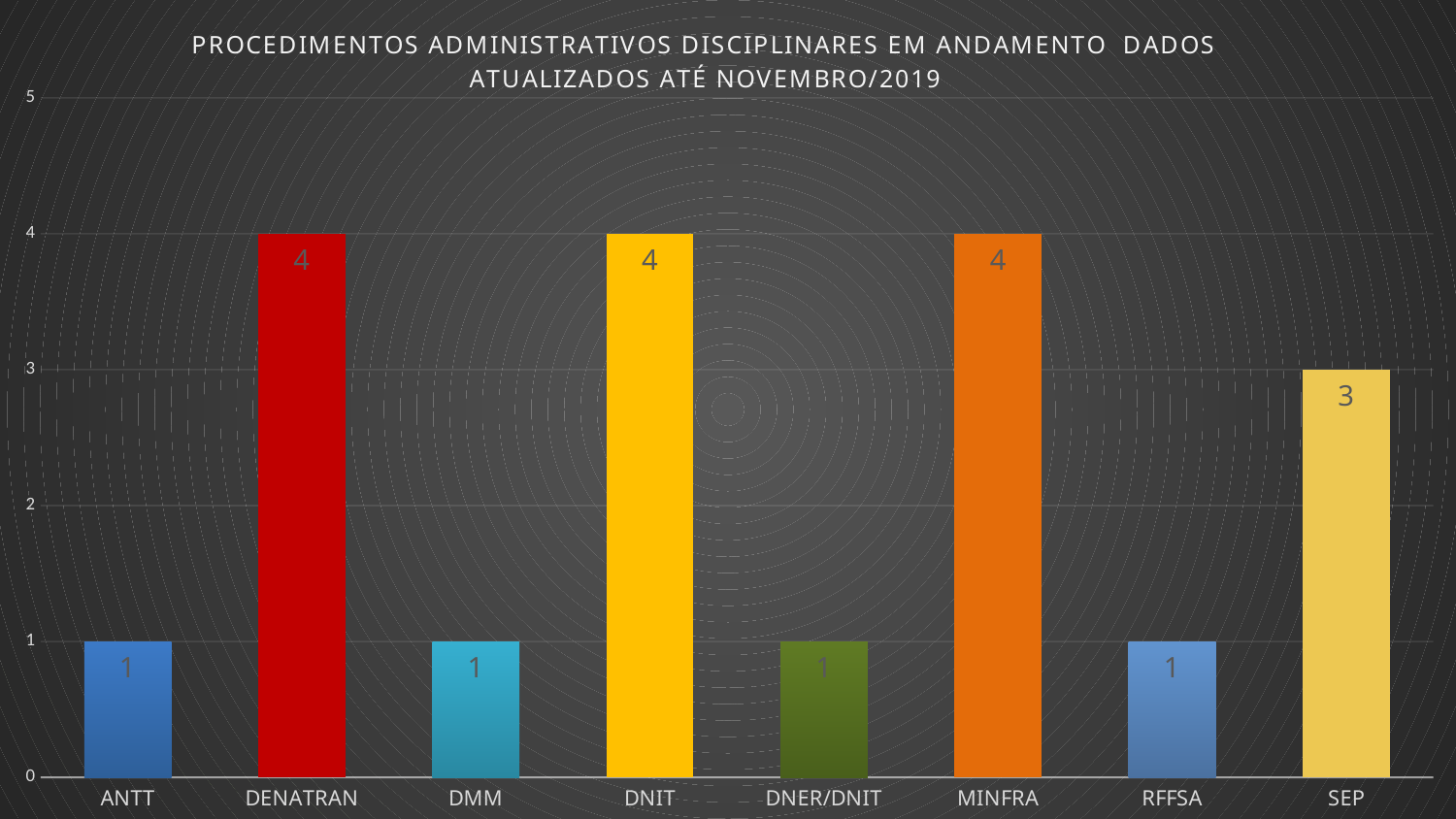
What is the difference between the values for SEP and RFFSA? 2 How many categories are shown on the x axis? 8 What is the title of the chart? PROCEDIMENTOS ADMINISTRATIVOS DISCIPLINARES EM ANDAMENTO DADOS ATUALIZADOS ATÉ NOVEMBRO/2019 Which is larger, the value for SEP or the value for ANTT? SEP Is the value for MINFRA greater or less than 2? greater Which category has the lowest value among DENATRAN, DNIT and SEP? SEP What is the difference between the values for DNIT and DMM? 3 What is the value for DENATRAN? 4 What is the value for DNER/DNIT? 1 What is the value for MINFRA? 4 What kind of chart is shown on the slide? bar chart What is the value for SEP? 3